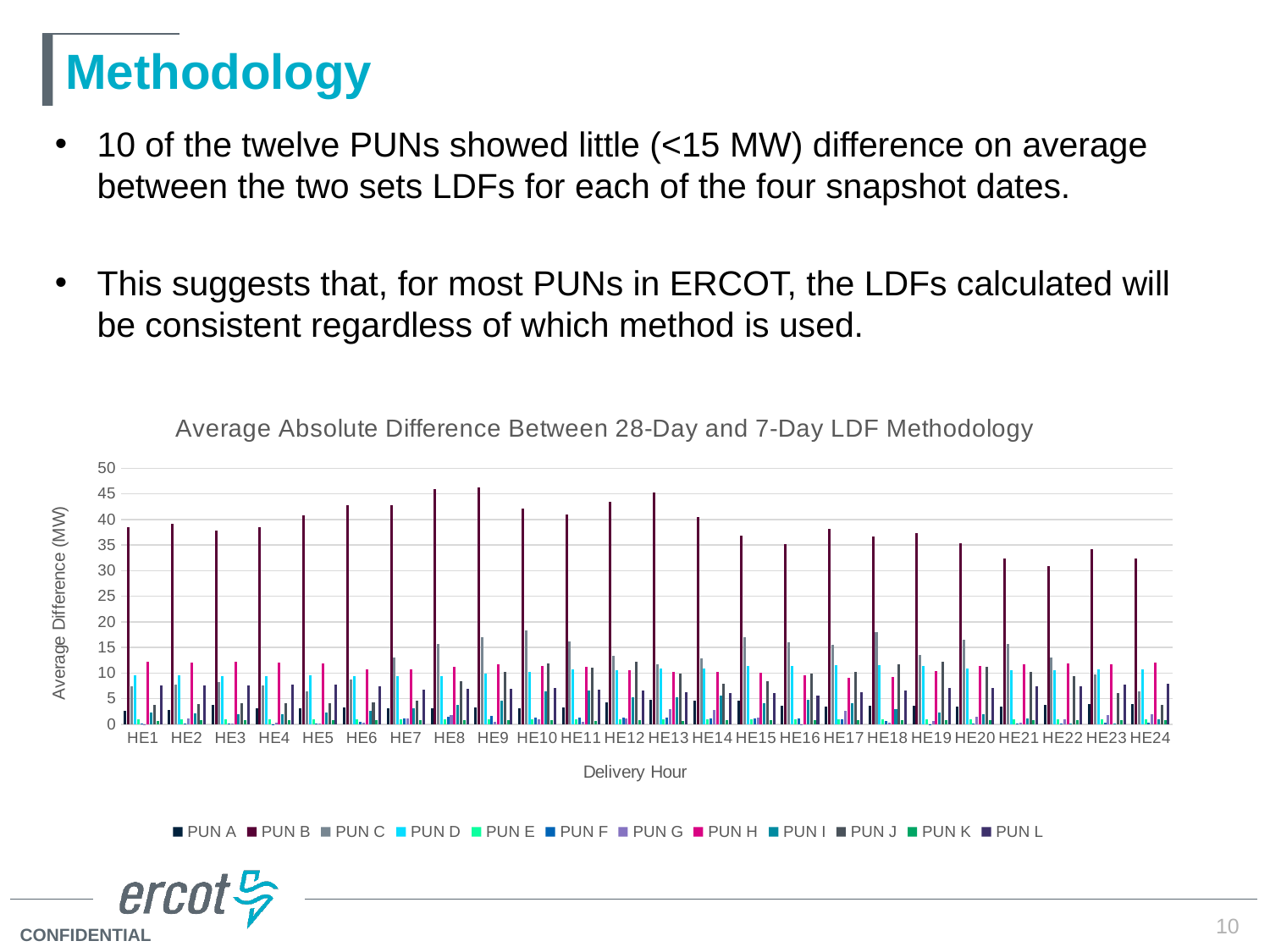
Is the value for PUN B larger at HE9 or at HE22? HE9 How many series does the chart legend list? 12 Is the value for PUN B at HE22 greater or less than 35? less What type of chart is shown on the slide? Bar chart What is the label of the y axis? Average Difference (MW) Is the value for PUN B at HE21 greater or less than 35? less Is the value for PUN B at HE9 greater or less than 40? greater What is the title of the chart? Average Absolute Difference Between 28-Day and 7-Day LDF Methodology How many delivery hour categories are shown on the x axis? 24 Do the PUN B values generally rise or fall from HE13 to HE22? fall Which series has the tallest bar in every delivery hour? PUN B